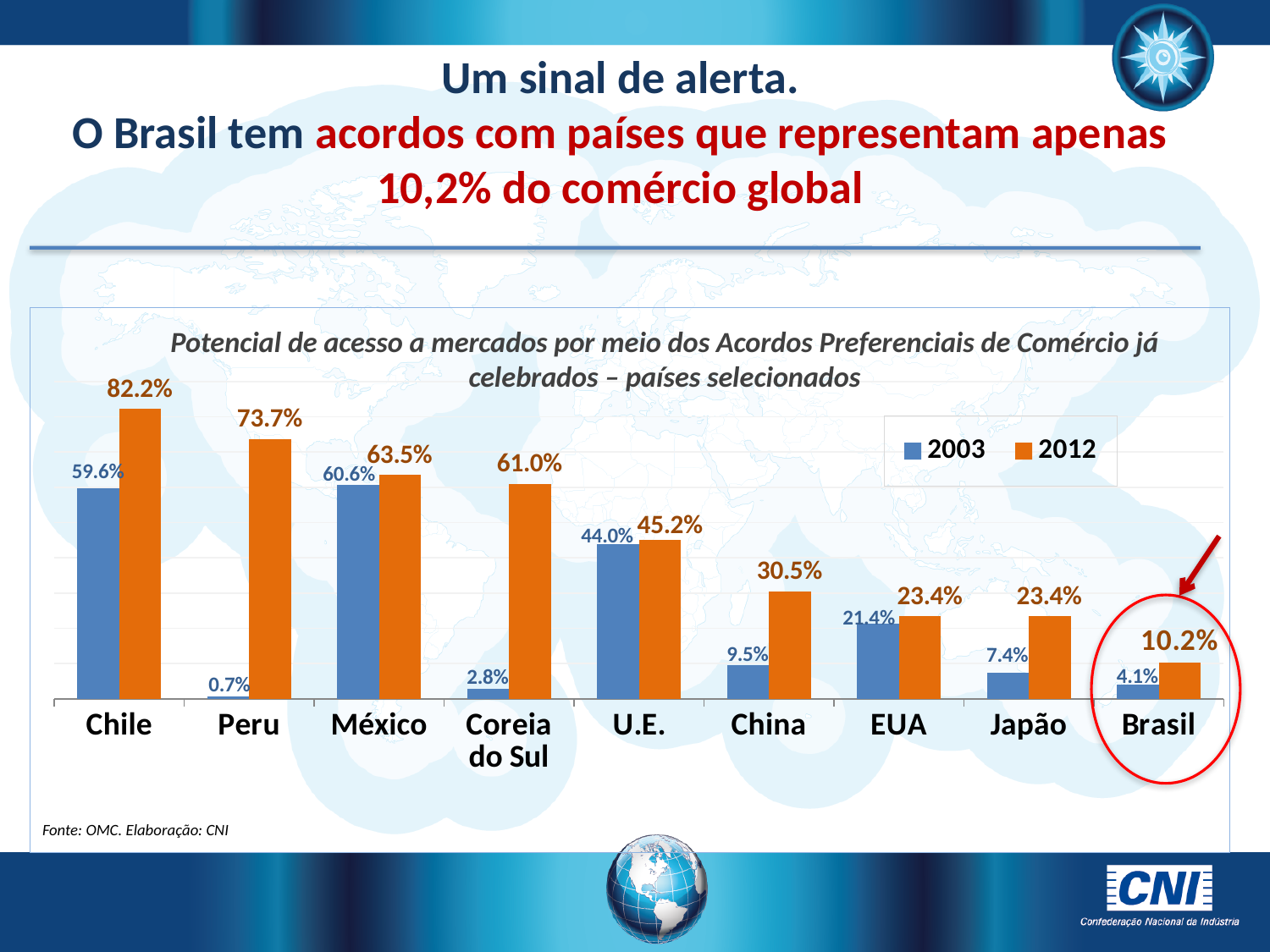
What kind of chart is shown on the slide? Bar chart How many series does the legend list? 2 Which is larger, the 2012 value for China or the 2012 value for EUA? China What is the 2012 value for Brasil? 10.2% What is the 2012 value for Chile? 82.2% What is the 2003 value for Peru? 0.7% What is the difference between the 2012 and 2003 values for Coreia do Sul? 58.2% How many countries are shown on the x axis? 9 What is the 2003 value for U.E.? 44.0% Which colour represents the 2012 series in the legend? Orange Which country has the highest 2012 value? Chile Which country has the lowest 2003 value? Peru